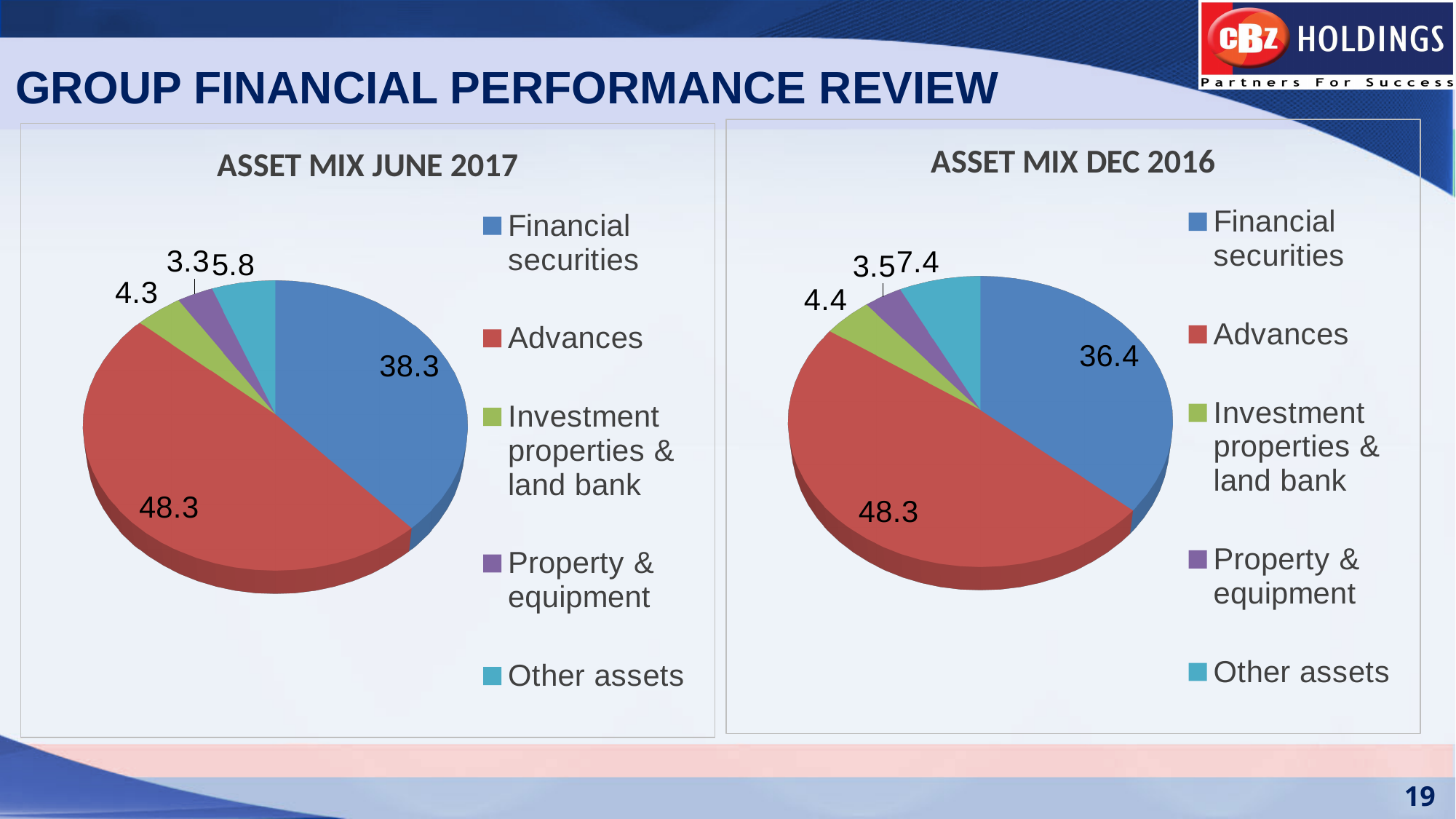
In the ASSET MIX JUNE 2017 chart, which colour represents Advances? Red In the ASSET MIX DEC 2016 chart, what is the difference between Financial securities and Other assets? 29 In the ASSET MIX DEC 2016 chart, which is larger, Other assets or Investment properties & land bank? Other assets How many categories does the ASSET MIX JUNE 2017 chart show? 5 In the ASSET MIX DEC 2016 chart, which category has the smallest slice? Property & equipment In the ASSET MIX JUNE 2017 chart, what is the difference between Advances and Financial securities? 10 What kind of chart is the ASSET MIX DEC 2016 chart? Pie chart In the ASSET MIX JUNE 2017 chart, which category has the largest slice? Advances In the ASSET MIX DEC 2016 chart, what is the value for Other assets? 7.4 In the ASSET MIX JUNE 2017 chart, what is the value for Financial securities? 38.3 In the ASSET MIX DEC 2016 chart, what is the value for Financial securities? 36.4 In the ASSET MIX JUNE 2017 chart, what is the value for Advances? 48.3